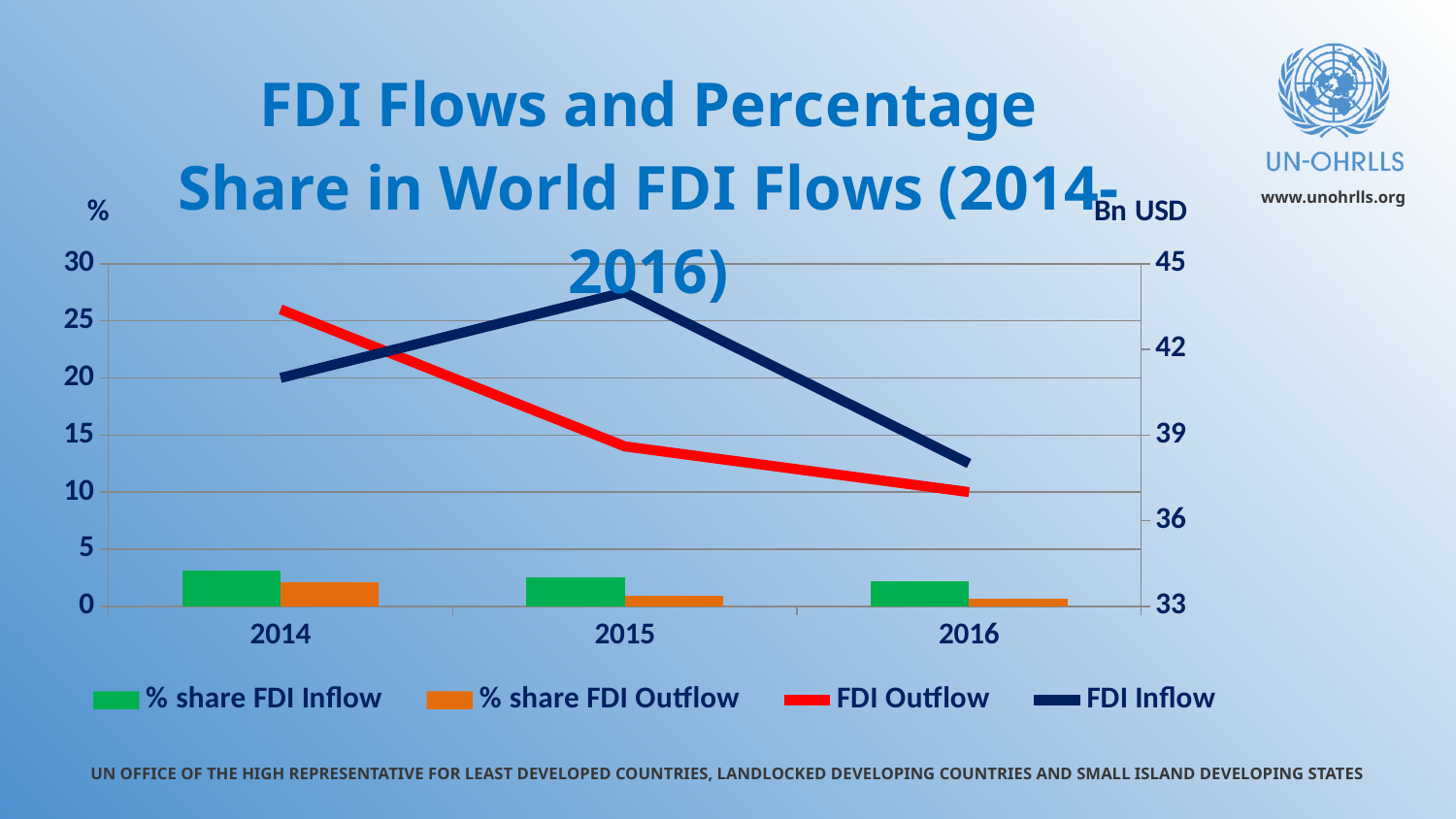
Is the value for FDI Inflow in 2015 greater or less than 42 Bn USD? greater How many series does the chart legend list? 4 How many years are shown on the x axis of the chart? 3 In which year is the FDI Outflow line at its highest? 2014 Does the FDI Outflow line rise or fall from 2014 to 2016? Fall In which year is the % share FDI Inflow bar the lowest? 2016 Is the value for FDI Outflow in 2016 greater or less than 39 Bn USD? less In which year is the FDI Inflow line at its highest? 2015 What unit is shown on the right-hand axis of the chart? Bn USD What kind of chart is shown on the slide? Combined bar and line chart